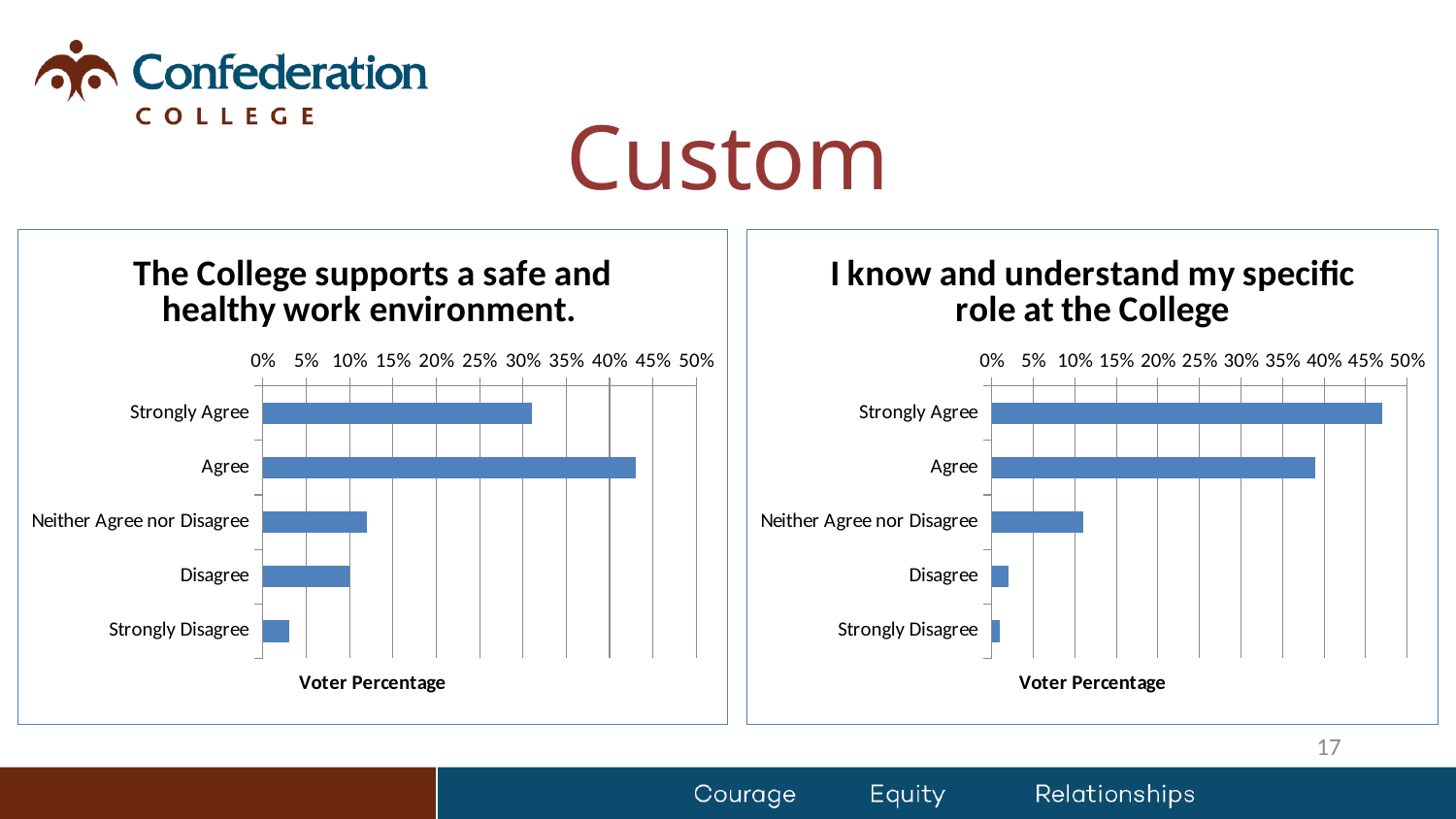
In the chart titled "The College supports a safe and healthy work environment.", is the value for Agree greater or less than 40%? greater How many categories are shown in the chart on the left of the slide? 5 In the chart titled "I know and understand my specific role at the College", which category has the lowest value? Strongly Disagree In the chart titled "I know and understand my specific role at the College", which is larger, the value for Strongly Agree or the value for Agree? Strongly Agree In the chart titled "The College supports a safe and healthy work environment.", which category has the highest value? Agree In the chart titled "I know and understand my specific role at the College", which category has the highest value? Strongly Agree In the chart titled "The College supports a safe and healthy work environment.", which is larger, the value for Strongly Agree or the value for Agree? Agree In the chart titled "The College supports a safe and healthy work environment.", is the value for Strongly Disagree greater or less than 5%? less In the chart titled "I know and understand my specific role at the College", is the value for Strongly Agree greater or less than 40%? greater In the chart titled "The College supports a safe and healthy work environment.", which category has the lowest value? Strongly Disagree What kind of chart is the chart on the right of the slide? Bar chart